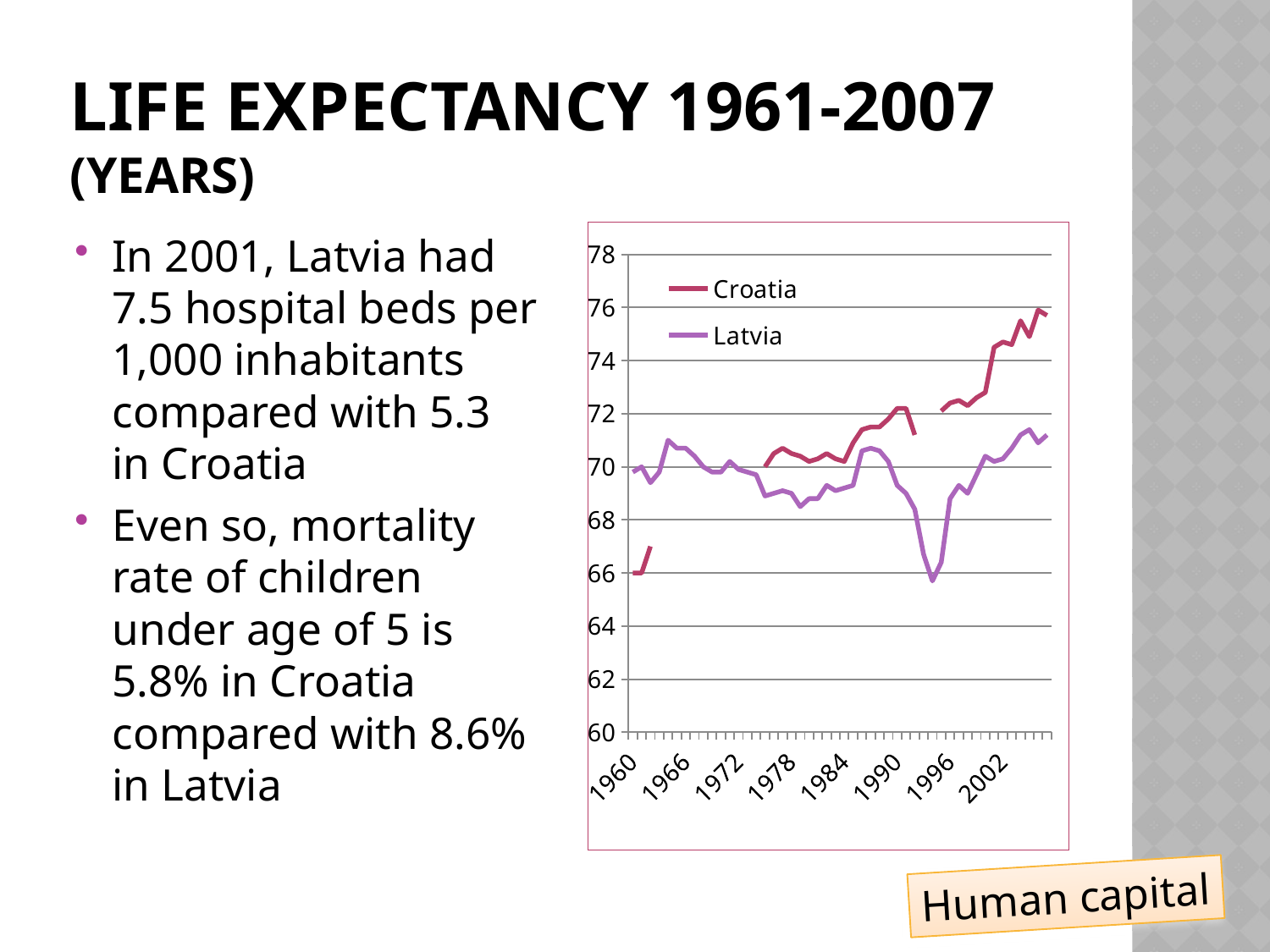
Is the lowest value for Latvia greater or less than 68? less What kind of chart is shown on the slide? line chart Is the value for Croatia in 1960 greater or less than 68? less Is the value for Latvia in 1960 greater or less than 72? less How many series does the chart's legend list? 2 Does the Croatia line rise or fall between 1996 and 2007? rise In 2002, which country has the higher life expectancy, Croatia or Latvia? Croatia Which series reaches the highest value on the chart? Croatia What colour is the line for Latvia? purple Which two countries are plotted in the chart? Croatia and Latvia